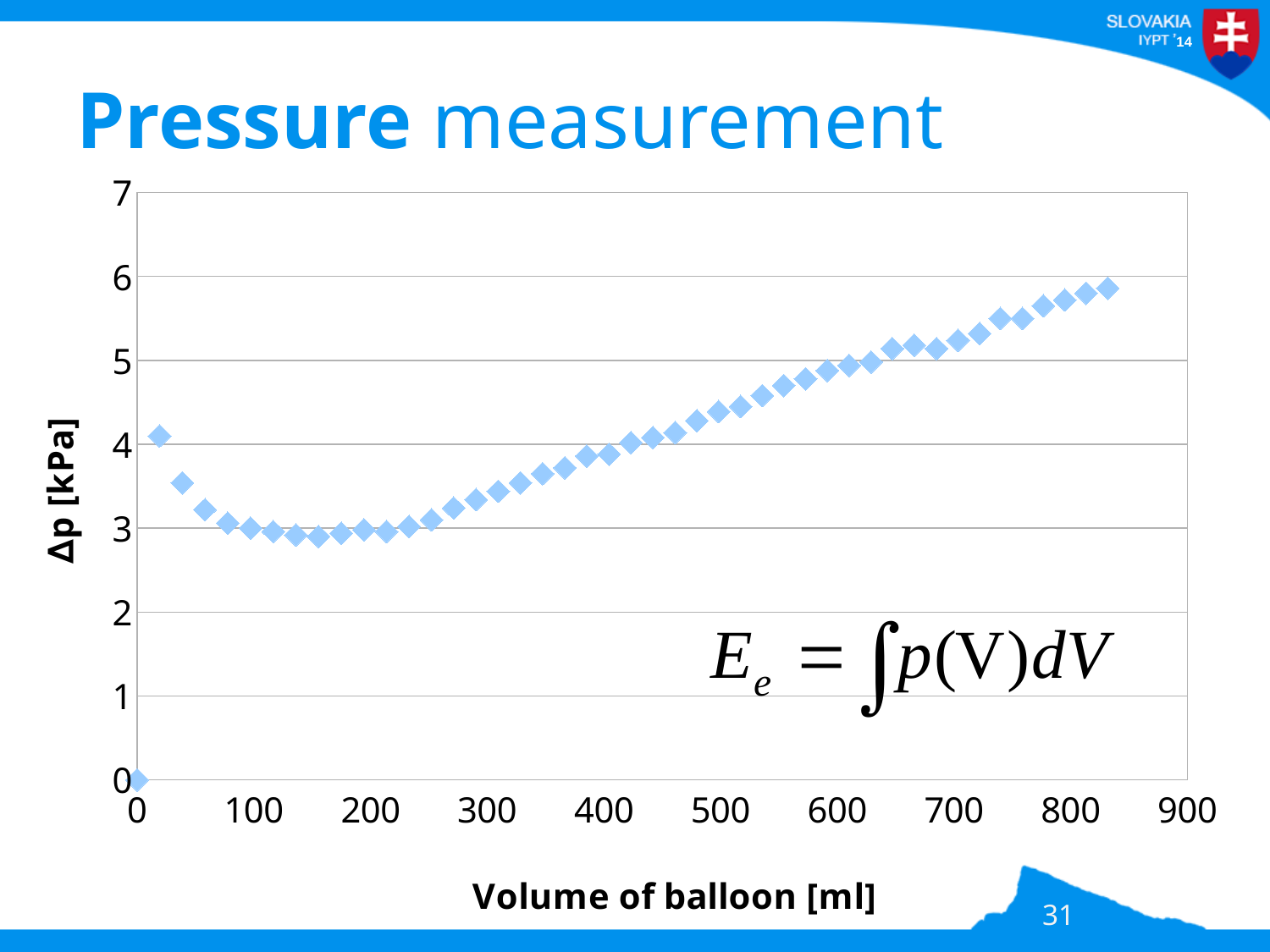
Is the value of Δp at a balloon volume of 500 ml greater or less than 4 kPa? greater What is the label of the vertical axis of the chart? Δp [kPa] Which is larger, the Δp value at 800 ml or the Δp value at 200 ml? 800 ml Between balloon volumes of 300 ml and 800 ml, do the Δp values rise or fall as volume increases? rise Is the value of Δp at a balloon volume of 100 ml greater or less than 4 kPa? less Is the value of Δp at a balloon volume of 600 ml greater or less than 6 kPa? less What is the label of the horizontal axis of the chart? Volume of balloon [ml] What kind of chart is shown on the slide? scatter chart Which is larger, the Δp value at 100 ml or the Δp value at 600 ml? 600 ml